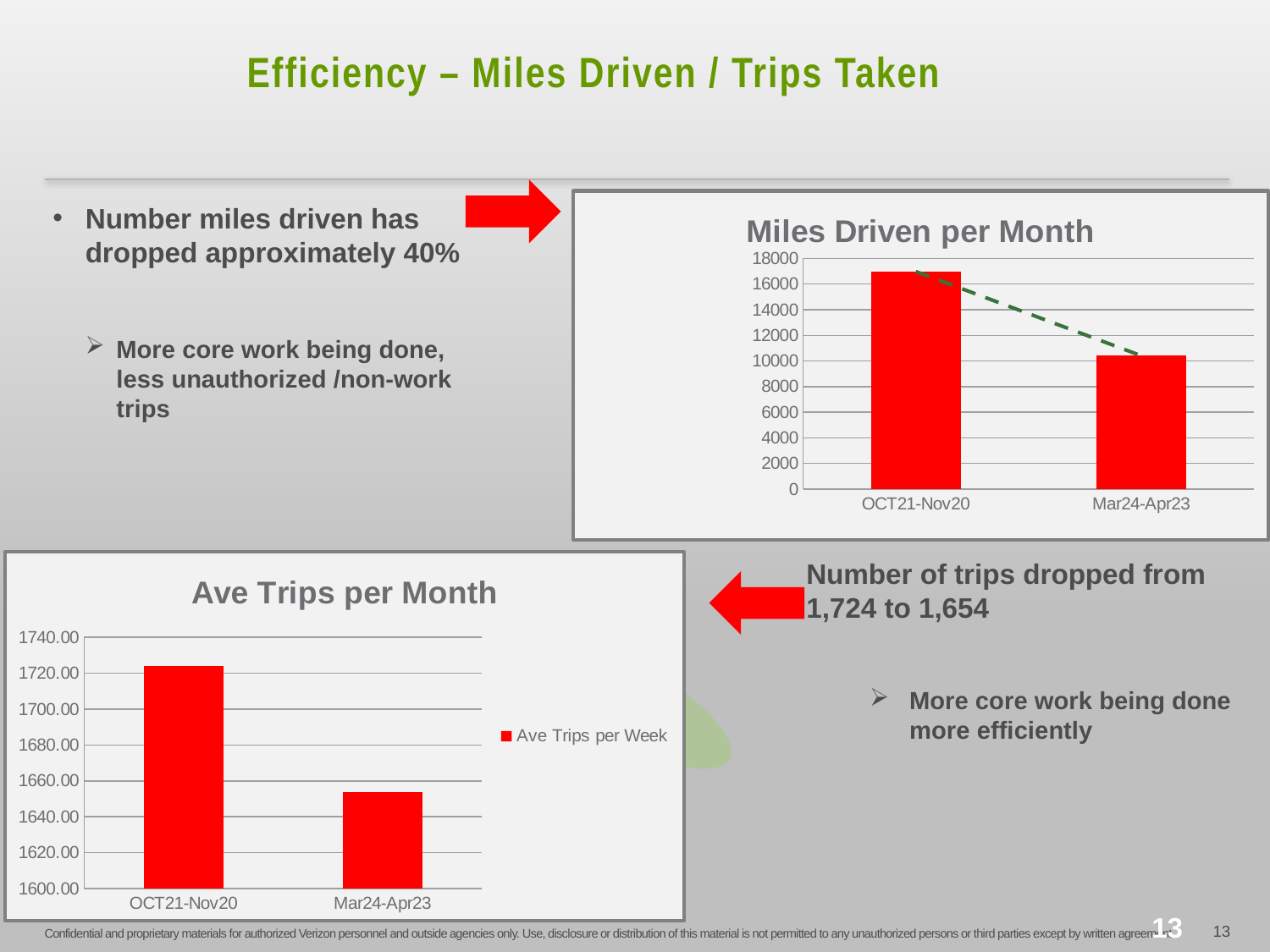
In the "Miles Driven per Month" chart, which category has the highest value? OCT21-Nov20 In the "Ave Trips per Month" chart, what is the legend entry? Ave Trips per Week In the "Miles Driven per Month" chart, do the values rise or fall from OCT21-Nov20 to Mar24-Apr23? fall In the "Miles Driven per Month" chart, how many categories are shown on the x axis? 2 In the "Ave Trips per Month" chart, which category has the larger value, OCT21-Nov20 or Mar24-Apr23? OCT21-Nov20 In the "Ave Trips per Month" chart, how many series does the legend list? 1 In the "Ave Trips per Month" chart, is the value for Mar24-Apr23 greater or less than 1660.00? less In the "Miles Driven per Month" chart, which category has the lowest value? Mar24-Apr23 In the "Miles Driven per Month" chart, is the value for Mar24-Apr23 greater or less than 12000? less In the "Miles Driven per Month" chart, is the value for OCT21-Nov20 greater or less than 16000? greater What kind of chart is the "Ave Trips per Month" chart? bar chart What kind of chart is the "Miles Driven per Month" chart? bar chart